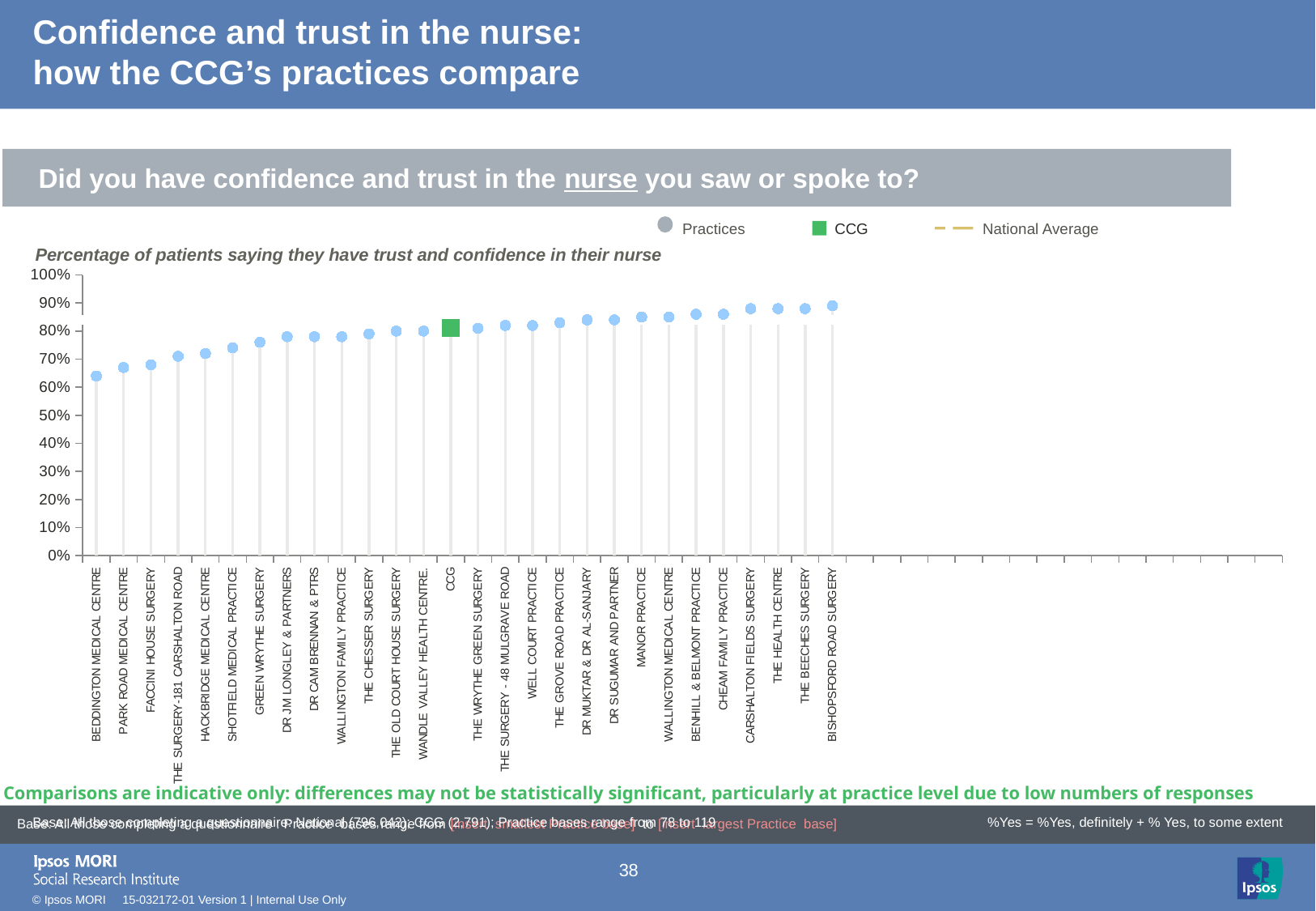
Which has a higher value, PARK ROAD MEDICAL CENTRE or MANOR PRACTICE? MANOR PRACTICE What colour is the marker used for the CCG in the chart? green Is the value for GREEN WRYTHE SURGERY greater or less than 70%? greater Do the plotted values rise or fall from left to right along the x axis? rise How many categories, including CCG, are plotted on the x axis? 28 Is the value for BISHOPSFORD ROAD SURGERY greater or less than 80%? greater Is the value for MANOR PRACTICE greater or less than 80%? greater Which practice has the lowest percentage of patients saying they have trust and confidence in their nurse? BEDDINGTON MEDICAL CENTRE Which has a higher value, BEDDINGTON MEDICAL CENTRE or BISHOPSFORD ROAD SURGERY? BISHOPSFORD ROAD SURGERY How many series does the legend list? 3